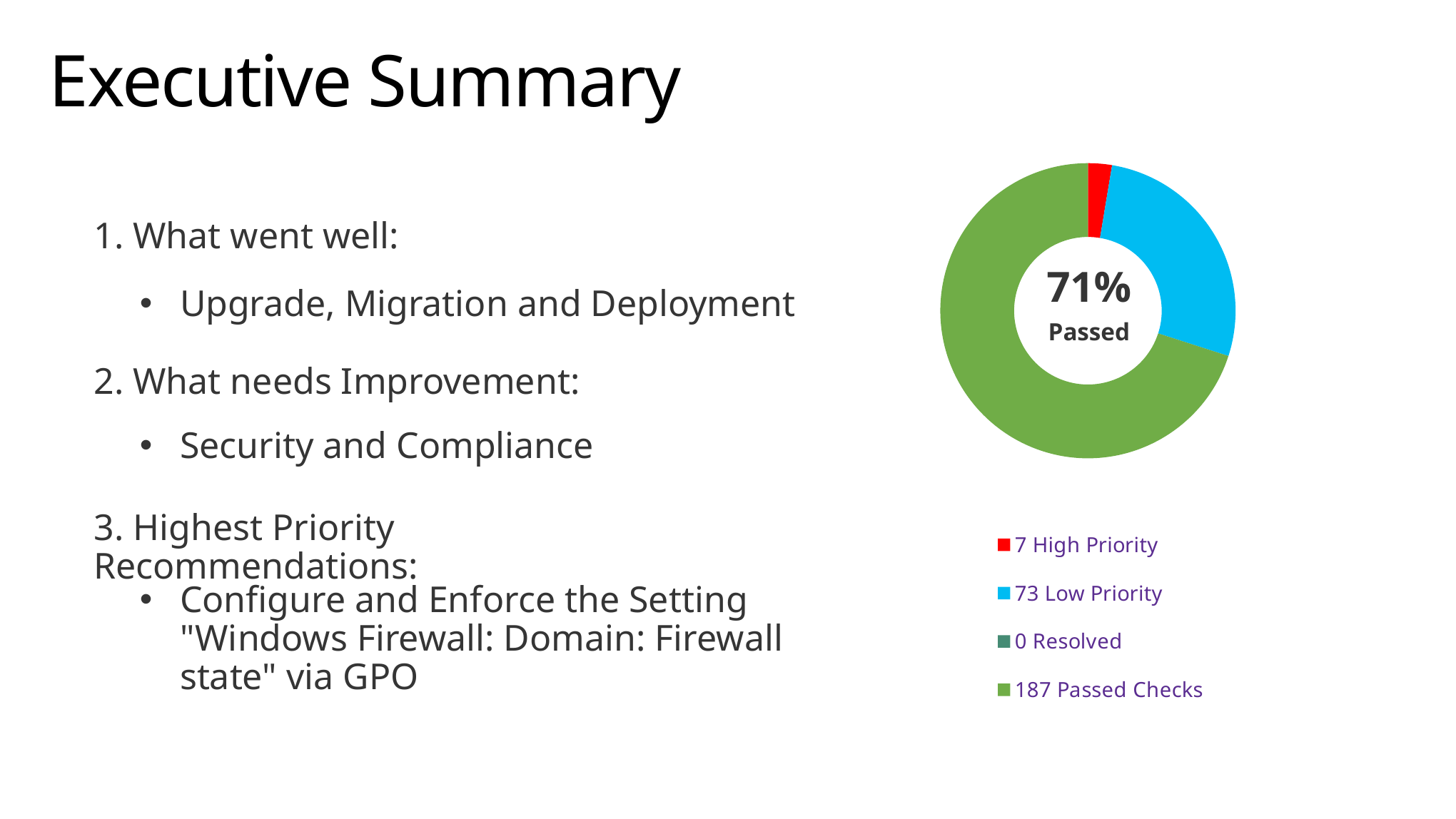
What is the total of all four values listed in the chart legend? 267 How many High Priority items does the chart legend show? 7 How many Passed Checks does the chart legend show? 187 How many Resolved items does the chart legend show? 0 Which category has the smallest value in the chart? Resolved Which is larger, the High Priority count or the Low Priority count? Low Priority What kind of chart is shown on the slide? pie chart (donut) How many Low Priority items does the chart legend show? 73 Which category has the largest value in the chart? Passed Checks What percentage is shown as Passed in the centre of the chart? 71% How many categories are listed in the chart legend? 4 What is the difference between the Low Priority and High Priority counts? 66